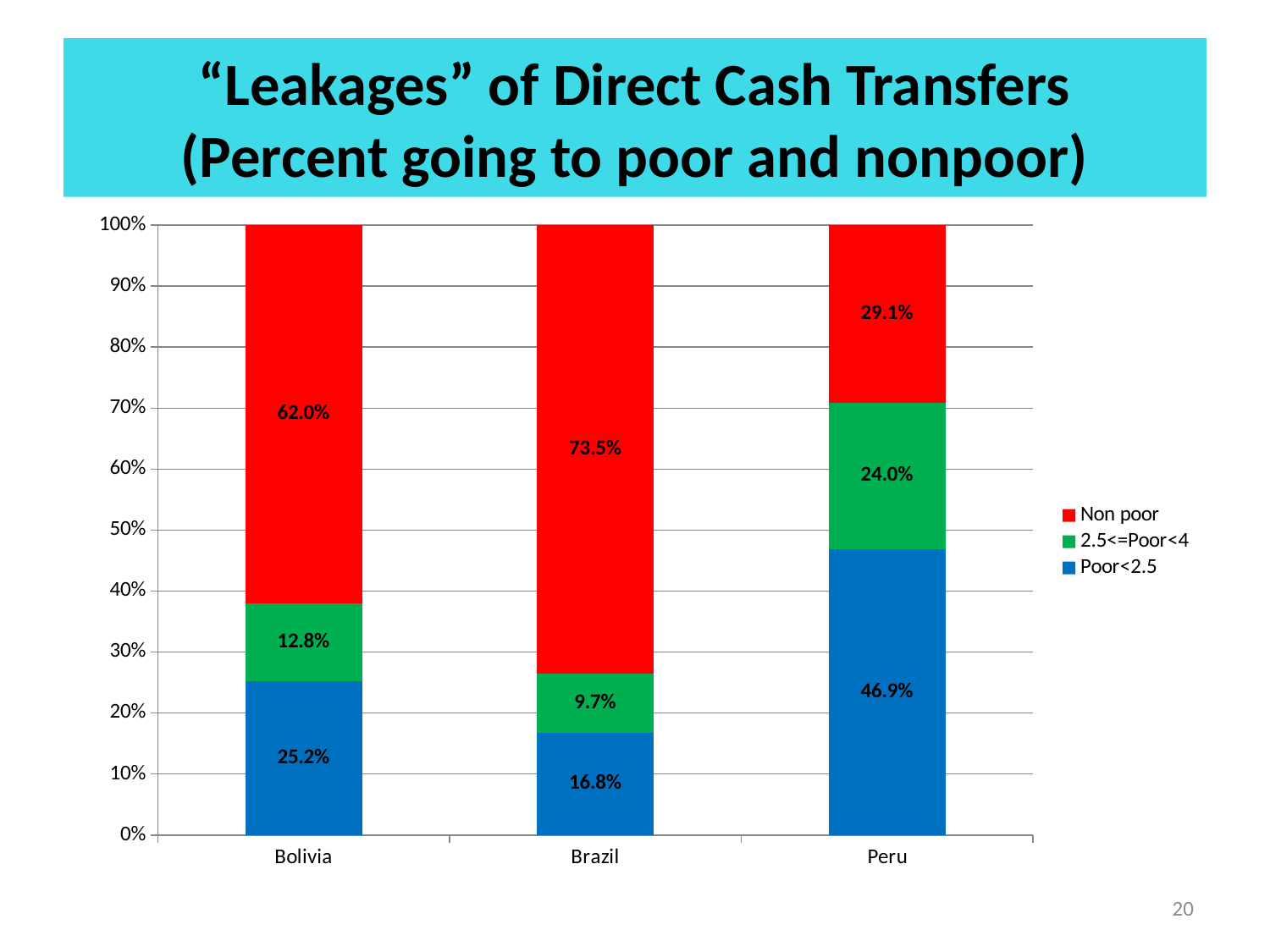
What is the difference between the Non poor shares of Brazil and Peru? 44.4% How many countries are shown on the x axis? 3 What is the combined share of the two poor categories (Poor<2.5 and 2.5<=Poor<4) for Peru? 70.9% Which country has the lowest Poor<2.5 share? Brazil How many series does the legend list? 3 What is the Non poor share for Brazil? 73.5% Which country has the highest Non poor share? Brazil What is the 2.5<=Poor<4 share for Bolivia? 12.8% What kind of chart is shown on the slide? Stacked bar chart Which colour represents the Non poor series in the legend? Red Which is larger, the Poor<2.5 share for Bolivia or for Peru? Peru What is the Poor<2.5 share for Peru? 46.9%